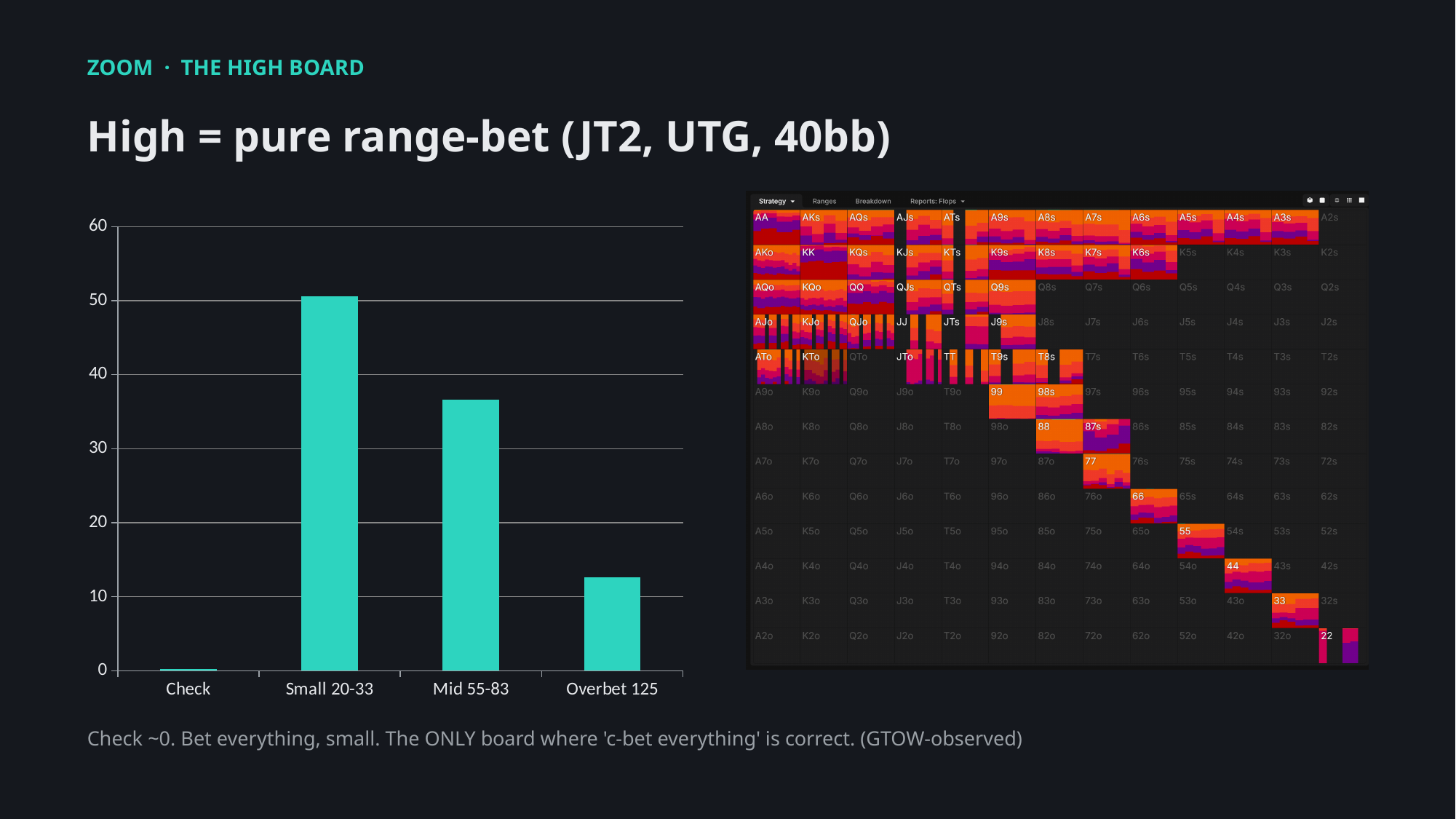
What colour are the bars in the bar chart? teal Which category has the highest bar in the bar chart? Small 20-33 Is the value for Mid 55-83 greater or less than 40? less What is the highest tick value shown on the y axis of the bar chart? 60 Is the value for Overbet 125 greater or less than 10? greater Which category has the lowest bar in the bar chart? Check Is the value for Check greater or less than 10? less Which is larger in the bar chart, Mid 55-83 or Overbet 125? Mid 55-83 What kind of chart is shown on the left of the slide? bar chart Which is larger in the bar chart, Small 20-33 or Mid 55-83? Small 20-33 How many categories does the bar chart on the left show? 4